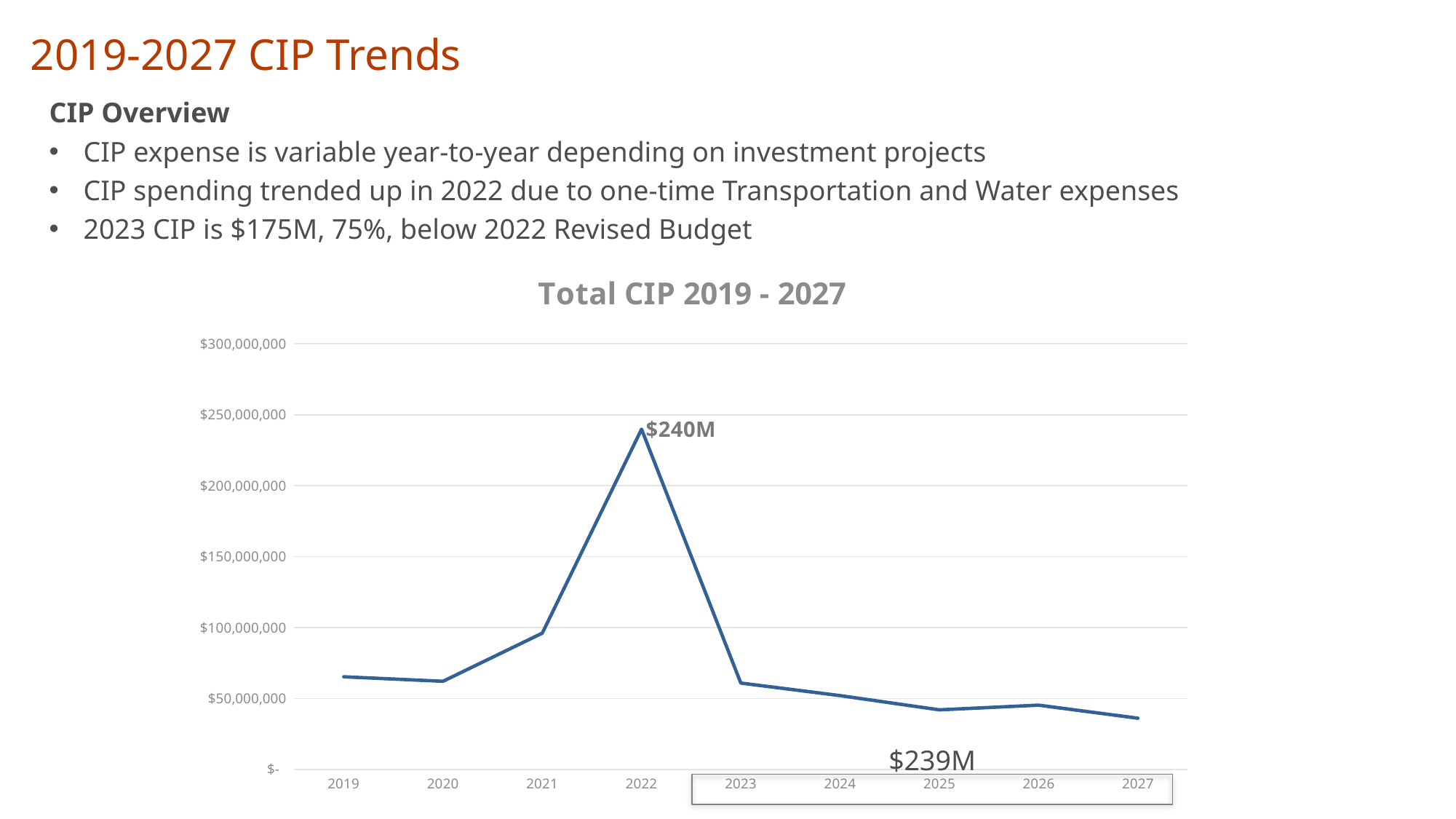
How many years are plotted on the x axis? 9 What type of chart is shown on the slide? line chart What is the title of the chart? Total CIP 2019 - 2027 Do the values generally rise or fall from 2023 to 2027? fall Is the value for 2019 greater or less than $50,000,000? greater Is the value for 2027 greater or less than $50,000,000? less What value is labelled on the chart for 2022? $240M Which year has the highest Total CIP value? 2022 Which year has the lowest Total CIP value? 2027 Which year has the larger value, 2020 or 2021? 2021 Is the value for 2022 greater or less than $200,000,000? greater